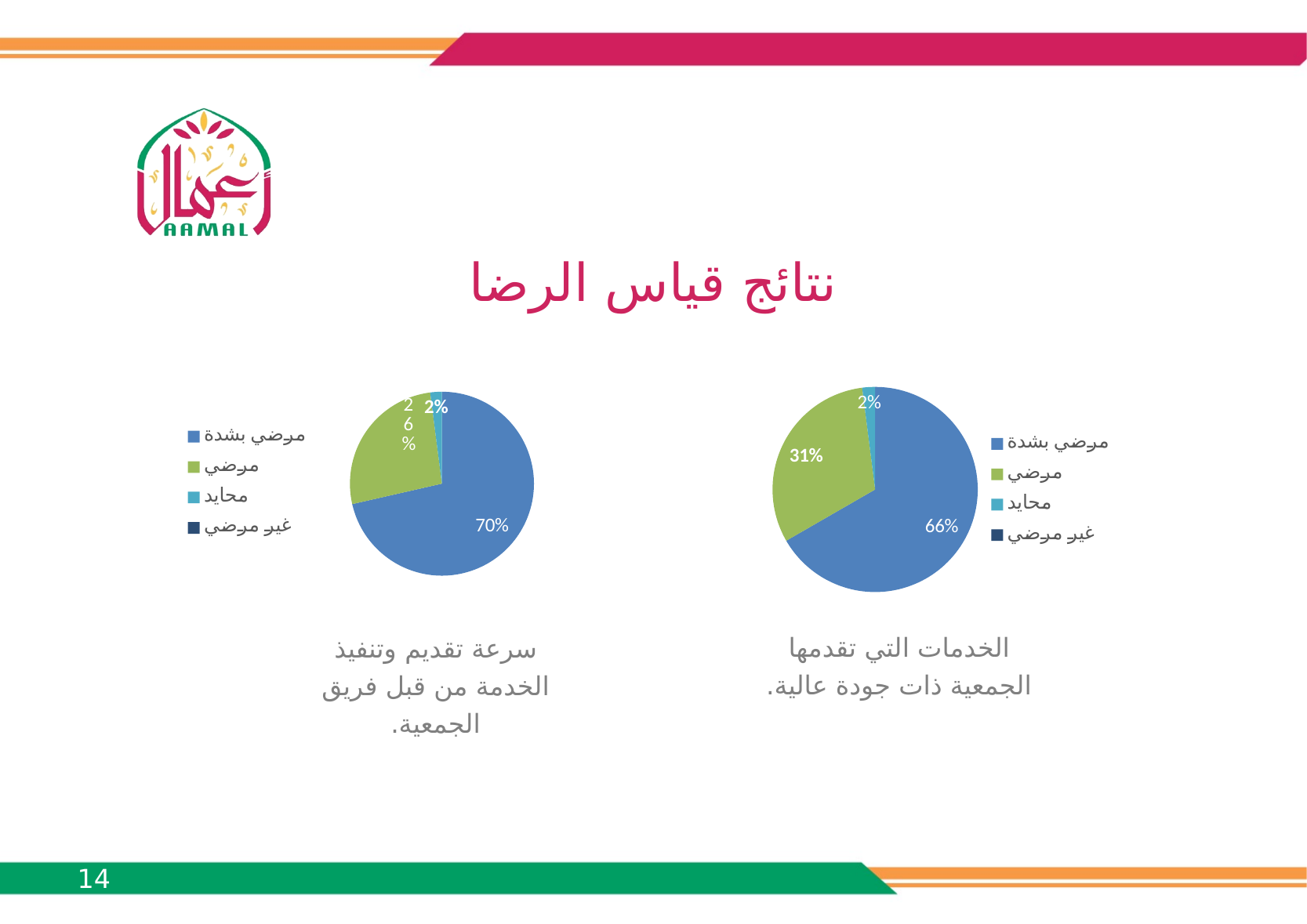
In the right pie chart, what is the difference between the مرضي بشدة share and the مرضي share? 35% In the left pie chart, which category has the largest slice? مرضي بشدة How many entries does the legend of the right pie chart list? 4 In the right pie chart (الخدمات التي تقدمها الجمعية ذات جودة عالية), what share is labelled for مرضي بشدة? 66% In the left pie chart (سرعة تقديم وتنفيذ الخدمة), what share is labelled for مرضي بشدة? 70% Which chart shows a larger share for مرضي بشدة, the left chart or the right chart? the left chart In the left pie chart (سرعة تقديم وتنفيذ الخدمة), what share is labelled for مرضي? 26% In the right pie chart, which category has the largest slice? مرضي بشدة What type of chart is used on the left of the slide? pie chart In the right pie chart (الخدمات التي تقدمها الجمعية ذات جودة عالية), what share is labelled for مرضي? 31% In the right pie chart (الخدمات التي تقدمها الجمعية ذات جودة عالية), what share is labelled for محايد? 2% What is the title of the slide? نتائج قياس الرضا